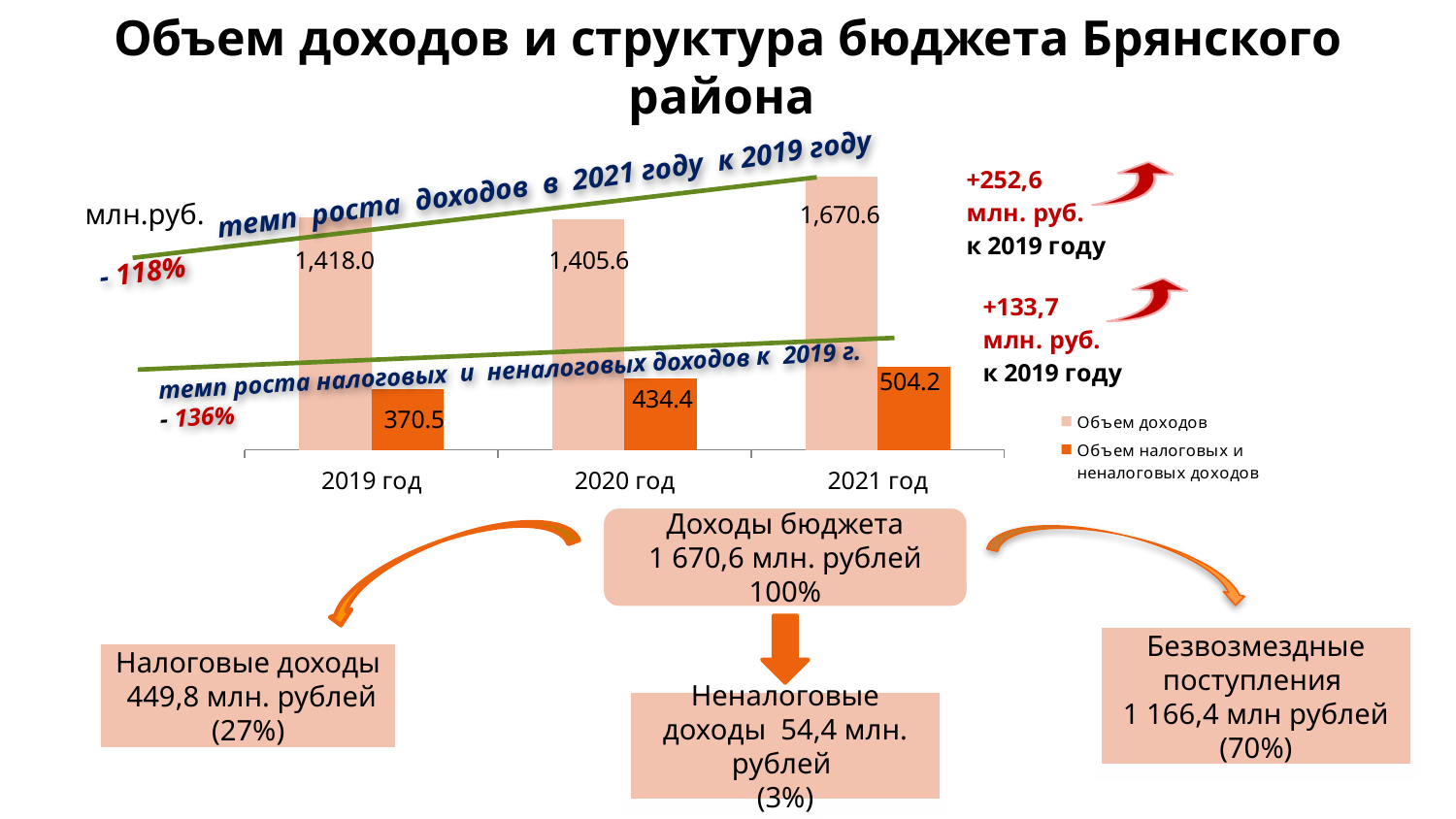
What is the value of Объем налоговых и неналоговых доходов for 2019 год? 370.5 How many years are shown on the x axis of the chart? 3 What is the difference between Объем доходов in 2021 год and in 2019 год? 252.6 What type of chart is shown on the slide? Bar chart What is the difference between Объем налоговых и неналоговых доходов in 2021 год and in 2020 год? 69.8 What is the value of Объем доходов for 2021 год? 1,670.6 How many series does the chart legend list? 2 In which year is Объем налоговых и неналоговых доходов the lowest? 2019 год Which is larger: Объем доходов in 2019 год or in 2020 год? 2019 год What is the value of Объем налоговых и неналоговых доходов for 2020 год? 434.4 What is the value of Объем доходов for 2020 год? 1,405.6 In which year is Объем доходов the highest? 2021 год